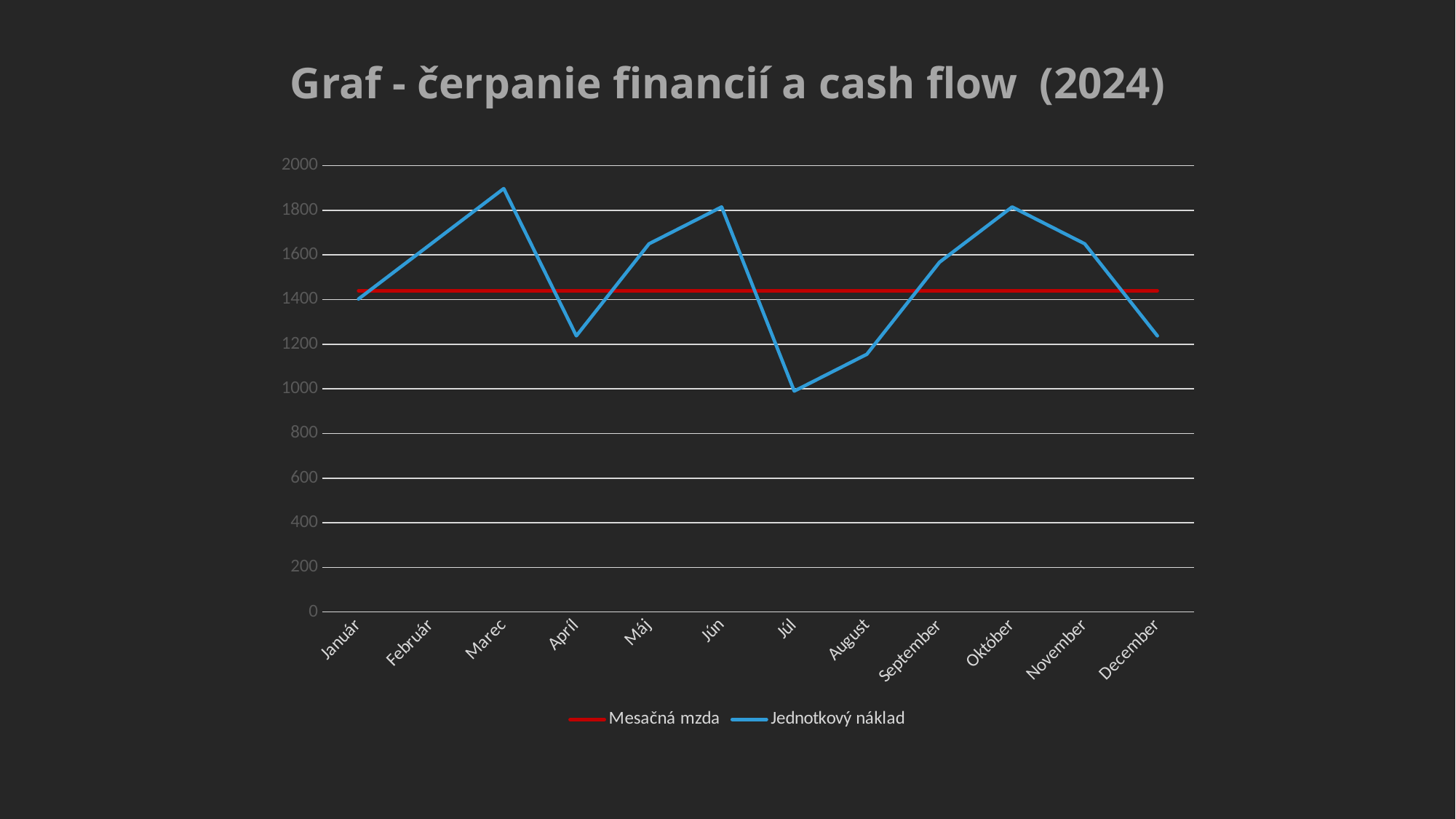
How many series does the legend list? 2 What is the title of the chart? Graf - čerpanie financií a cash flow (2024) Is the value of Jednotkový náklad for Júl greater or less than 1200? less Is the value of Jednotkový náklad for Apríl greater or less than 1400? less How many months are plotted along the x axis? 12 Does Jednotkový náklad rise or fall from Júl to Október? rise Is the value of Mesačná mzda greater or less than 1400? greater In which month is Jednotkový náklad lowest? Júl In which month is Jednotkový náklad highest? Marec Which is larger, Jednotkový náklad for Jún or for Júl? Jún What kind of chart is shown on the slide? line chart